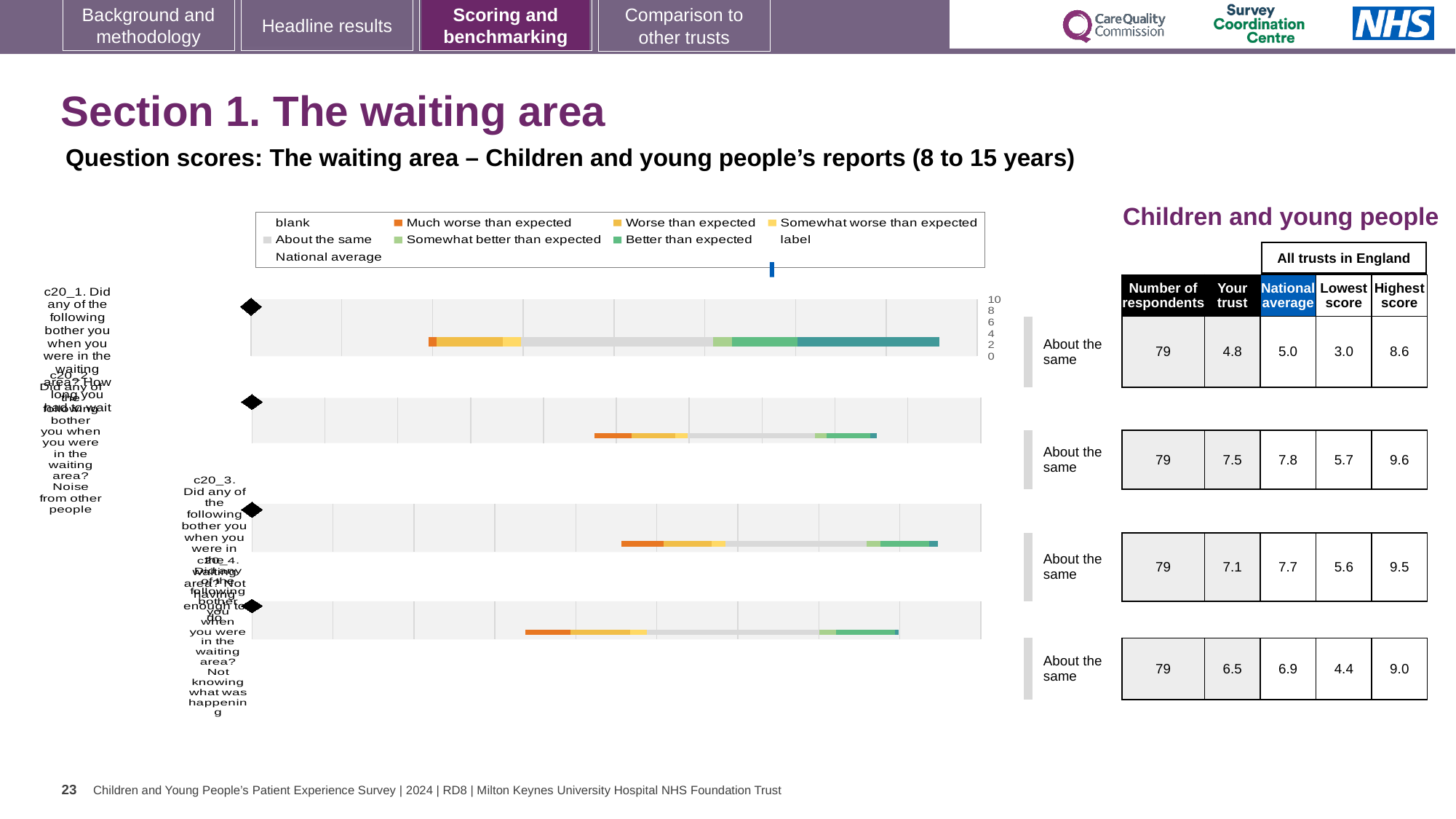
In the table next to the charts, what is the highest score for the third question (c20_3, Not having enough to do)? 9.5 How many entries does the legend above the bar charts list? 9 In the table next to the charts, what is the national average for the second question (c20_2, Noise from other people)? 7.8 In the table next to the charts, what is the 'Your trust' score for the first question (c20_1, How long you had to wait)? 4.8 Which legend entry is shown in orange in the bar charts? Much worse than expected What is the benchmark category shown next to the bar chart for question c20_1 (Did any of the following bother you when you were in the waiting area? How long you had to wait)? About the same In the table next to the charts, what is the lowest score for the fourth question (c20_4, Not knowing what was happening)? 4.4 How many separate bar charts are shown on the slide for the waiting area questions? 4 What kind of chart is used to show the question scores for the waiting area? Bar chart In the table next to the charts, which question has the highest 'Your trust' score? c20_2 (Noise from other people), 7.5 In the table next to the charts, how many respondents are listed for each of the four waiting area questions? 79 Which legend entry is shown in light grey in the bar charts? About the same